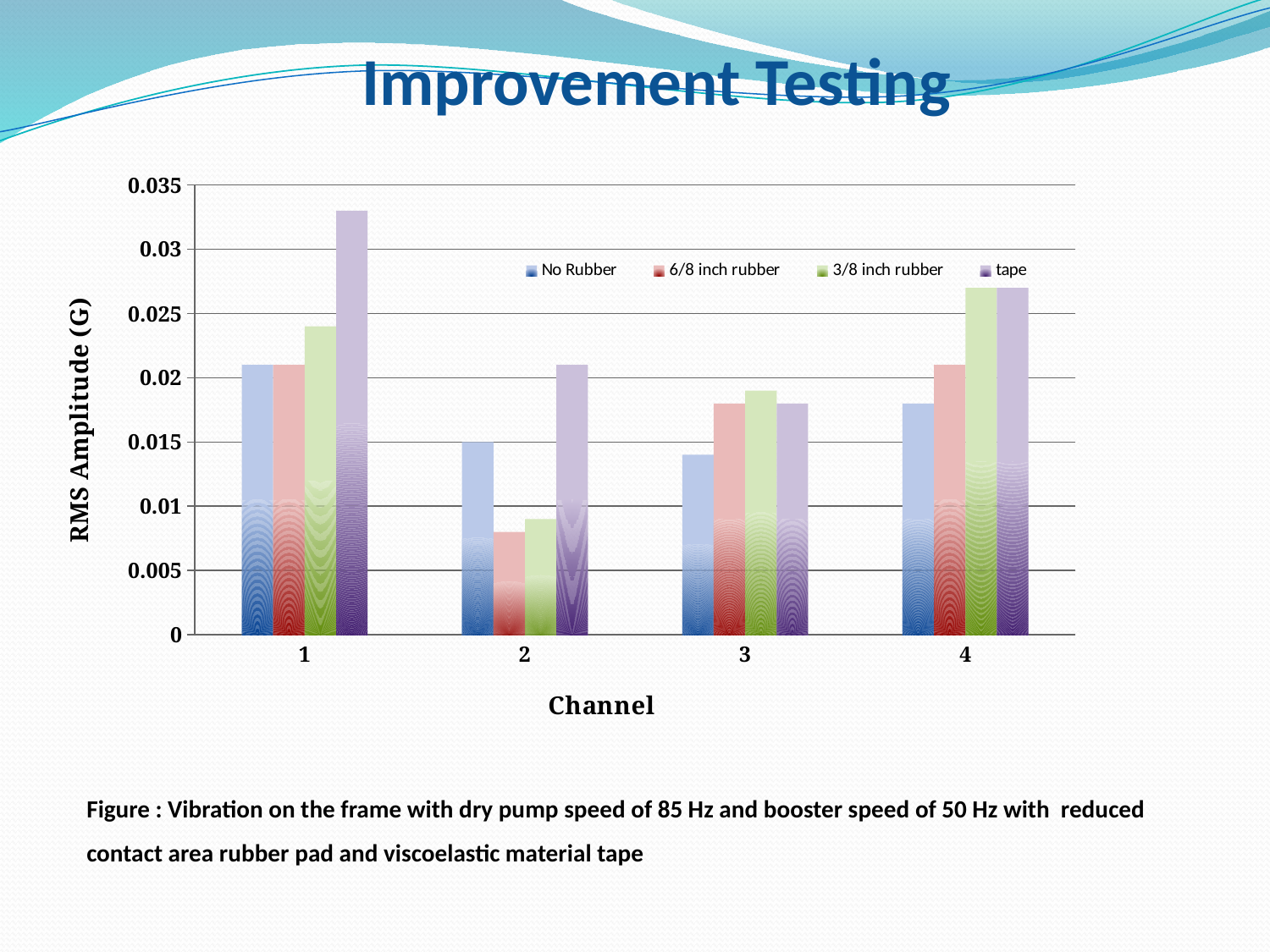
For channel 2, which is larger: the tape value or the 3/8 inch rubber value? tape How many series does the legend list? 4 How many channels are shown on the x axis? 4 Which channel has the lowest 6/8 inch rubber bar? 2 Is the 3/8 inch rubber value for channel 4 greater or less than 0.025? greater Which series has the tallest bar in the whole chart? tape Is the 6/8 inch rubber value for channel 2 greater or less than 0.01? less What kind of chart is shown on the slide? bar chart Which channel has the highest tape bar? 1 Is the tape value for channel 1 greater or less than 0.03? greater What is the label of the vertical axis? RMS Amplitude (G)